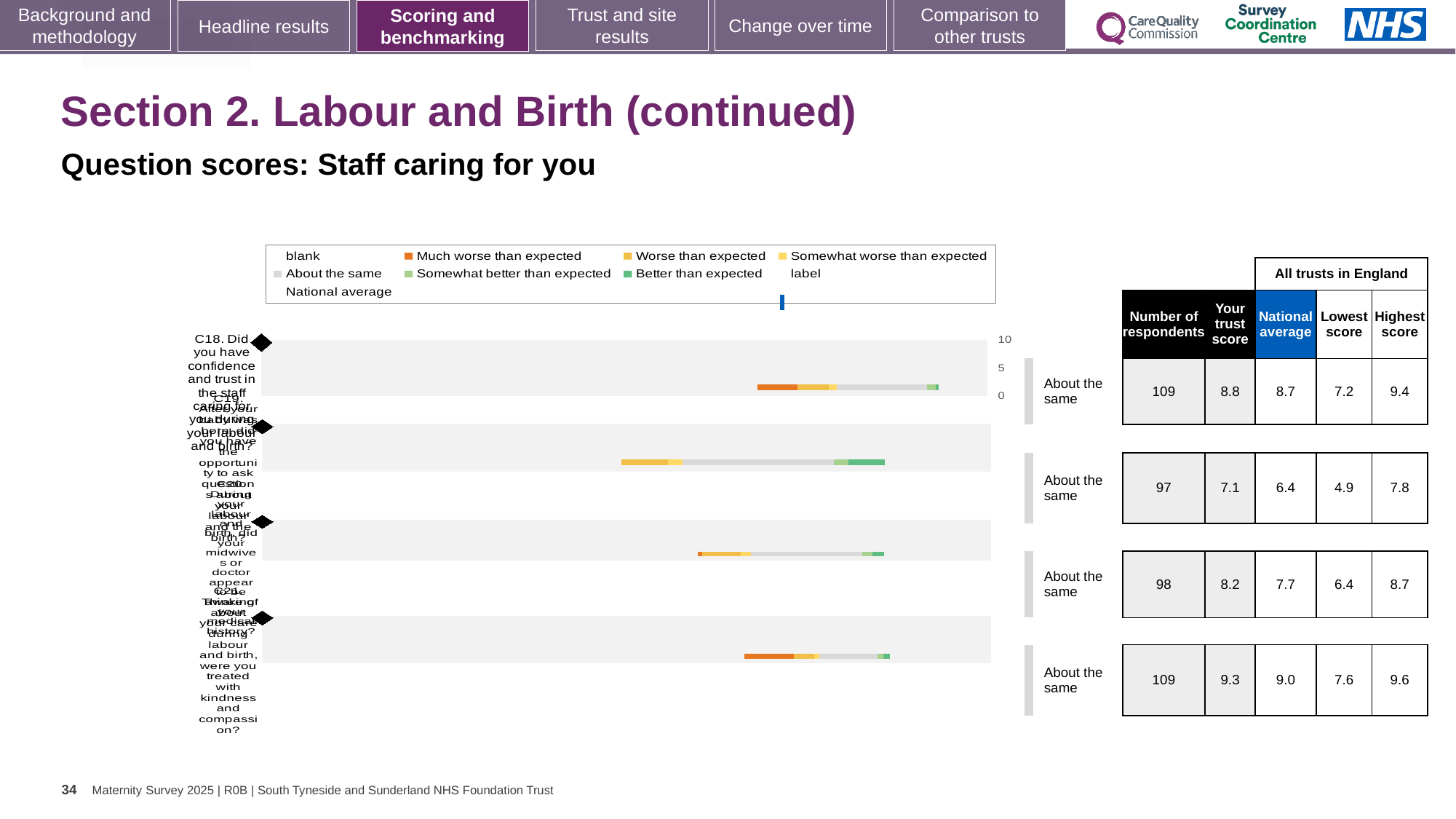
What kind of chart is shown on the slide? bar chart For the second row, which is larger: 'Your trust score' or the National average? Your trust score (7.1) For the first row (C18), what is the difference between 'Your trust score' and the National average? 0.1 Which row of the table has the lowest 'Your trust score'? the second row, 7.1 In the table, what is the Lowest score for the third row? 6.4 How many question rows (bars) does the chart show? 4 In the table, what is the 'Your trust score' for the first row (C18, confidence and trust in the staff)? 8.8 Which row of the table has the highest 'Your trust score'? the fourth (bottom) row, 9.3 In the table, what is the National average for the second row? 6.4 In the table, what is the Number of respondents for the third row? 98 What comparison label is shown next to each of the four rows? About the same In the table, what is the Highest score for the fourth (bottom) row? 9.6